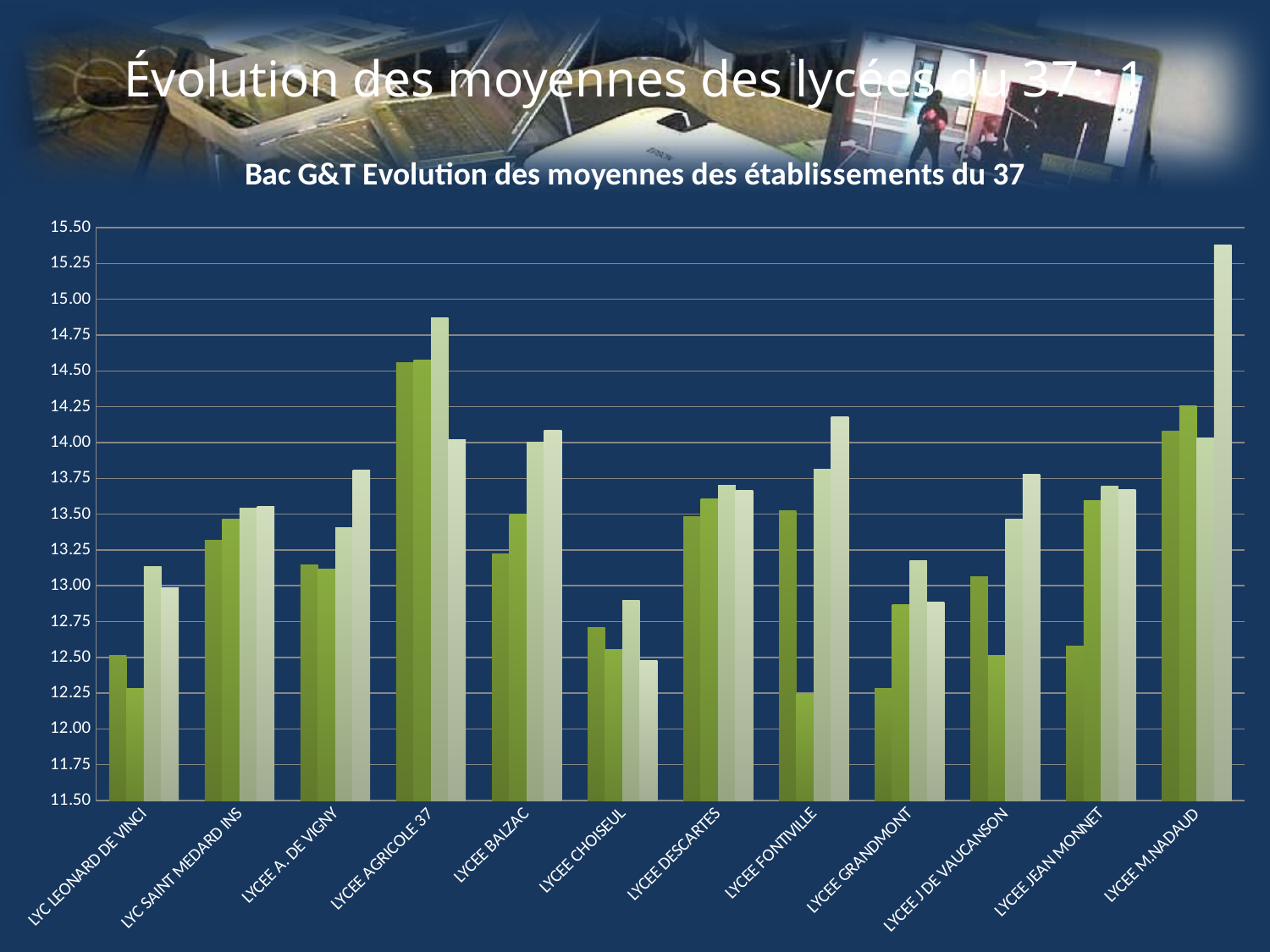
Is the last bar for LYCEE FONTIVILLE greater or less than 14.00? greater Is the first bar for LYCEE CHOISEUL greater or less than 13.00? less Is the tallest bar for LYCEE M.NADAUD greater or less than 15.00? greater Which lycée has the higher tallest bar, LYCEE AGRICOLE 37 or LYCEE M.NADAUD? LYCEE M.NADAUD Which lycée has the higher first bar, LYCEE AGRICOLE 37 or LYCEE BALZAC? LYCEE AGRICOLE 37 Which lycée has the single tallest bar in the chart? LYCEE M.NADAUD How many lycées (categories) are shown on the x axis of the chart? 12 What is the title of the chart? Bac G&T Evolution des moyennes des établissements du 37 How many bars are plotted for each lycée in the chart? 4 What kind of chart is shown on the slide? bar chart